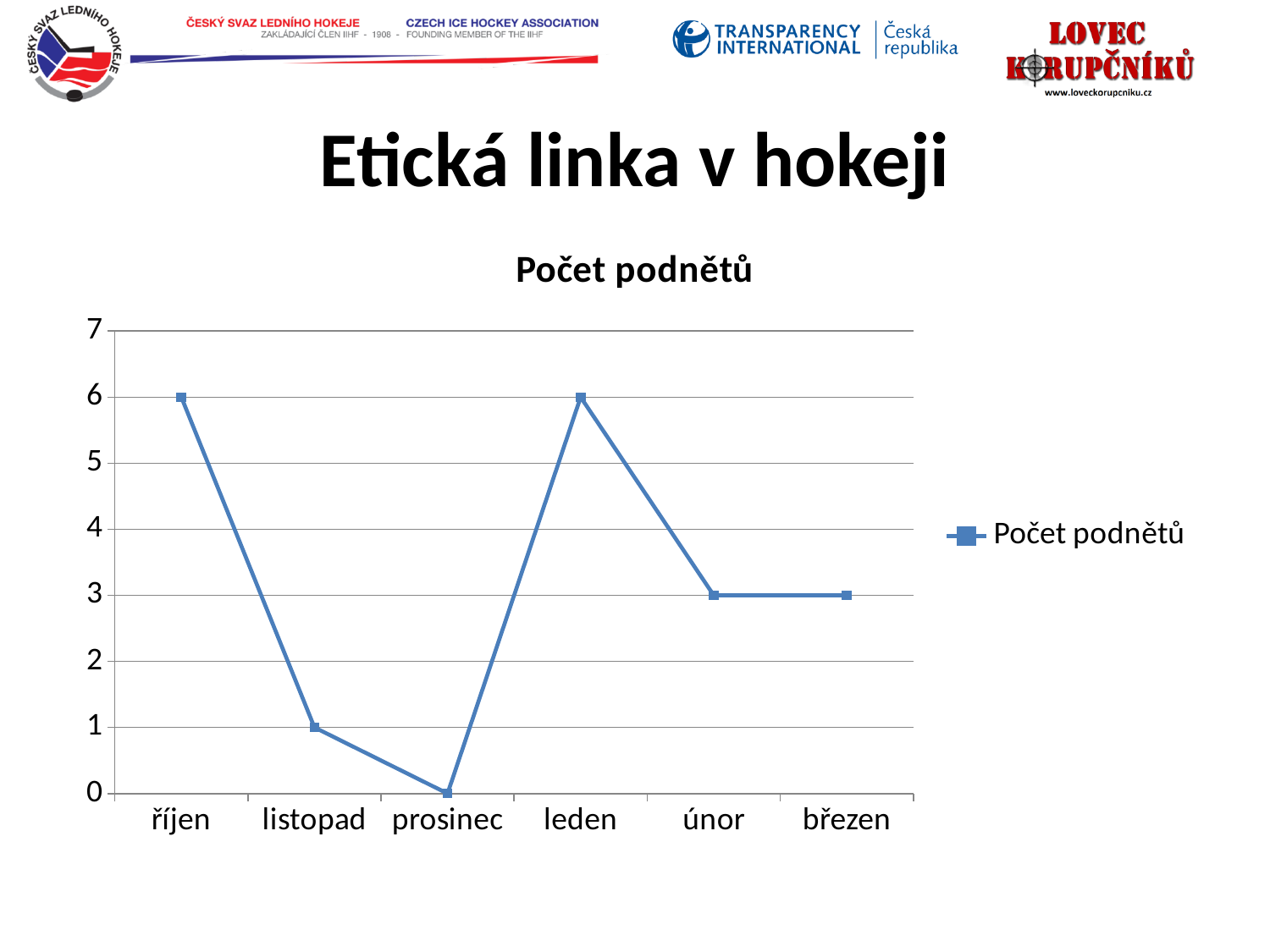
Does the value fall or rise from říjen to listopad? fall What type of chart is shown on the slide? line chart How many months are plotted on the x axis? 6 What is the value for únor? 3 What is the value for listopad? 1 What is the value for říjen? 6 What is the value for prosinec? 0 Which month has the lowest value? prosinec How many series does the legend list? 1 Which is larger, the value for listopad or the value for březen? březen What is the title of the chart? Počet podnětů What is the difference between the values for leden and únor? 3